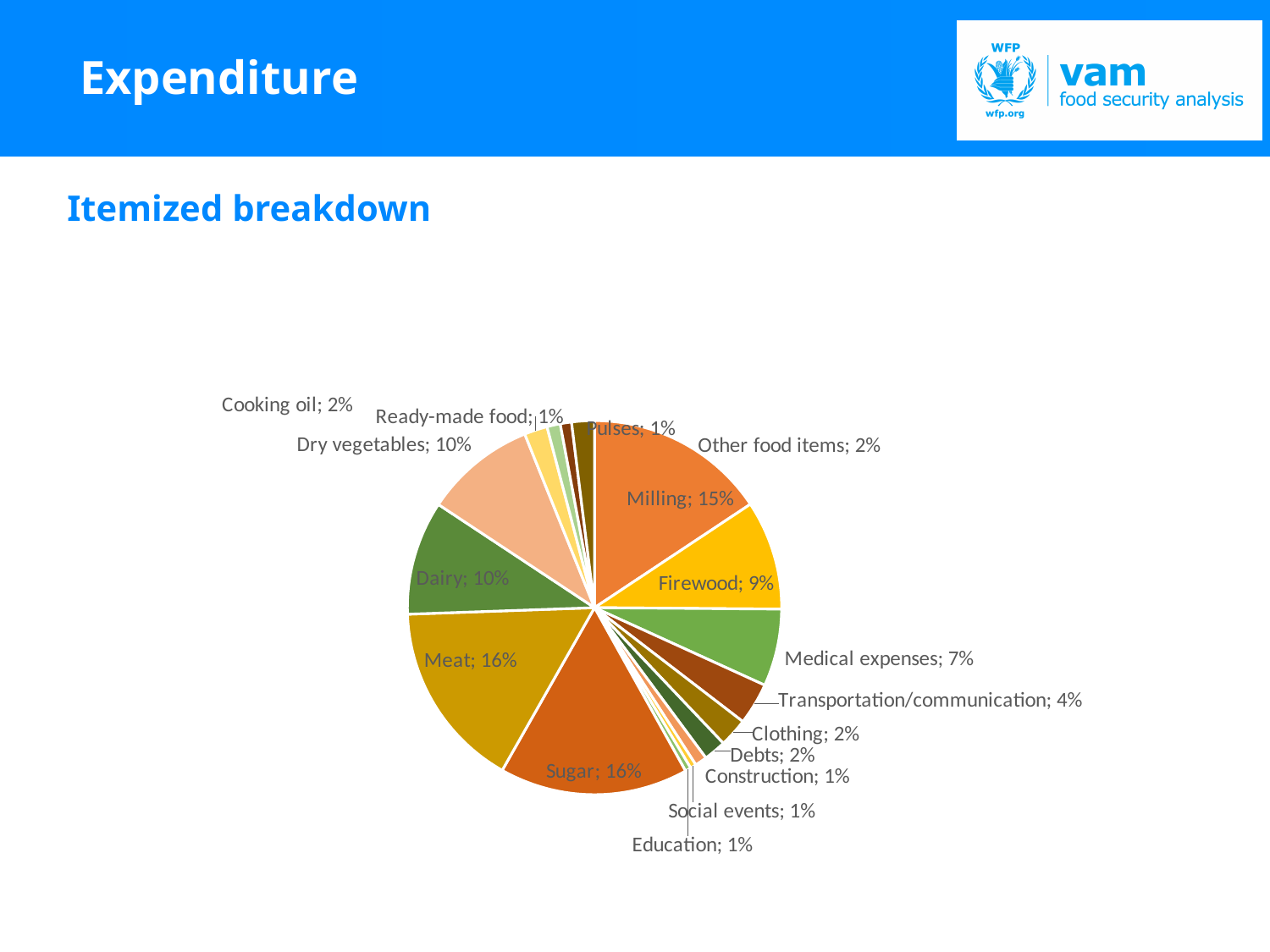
What kind of chart is shown on the slide? pie chart Which is larger, Milling or Firewood? Milling What share of expenditure goes to Milling? 15% What is the value for Transportation/communication? 4% What share of expenditure goes to Firewood? 9% Which is larger, Dairy or Medical expenses? Dairy What is the value for Medical expenses? 7% How many categories are shown in the pie chart? 17 What is the difference between Medical expenses and Transportation/communication? 3% What is the value for Dry vegetables? 10% What is the value for Meat? 16% What is the difference between the Milling and Firewood shares? 6%